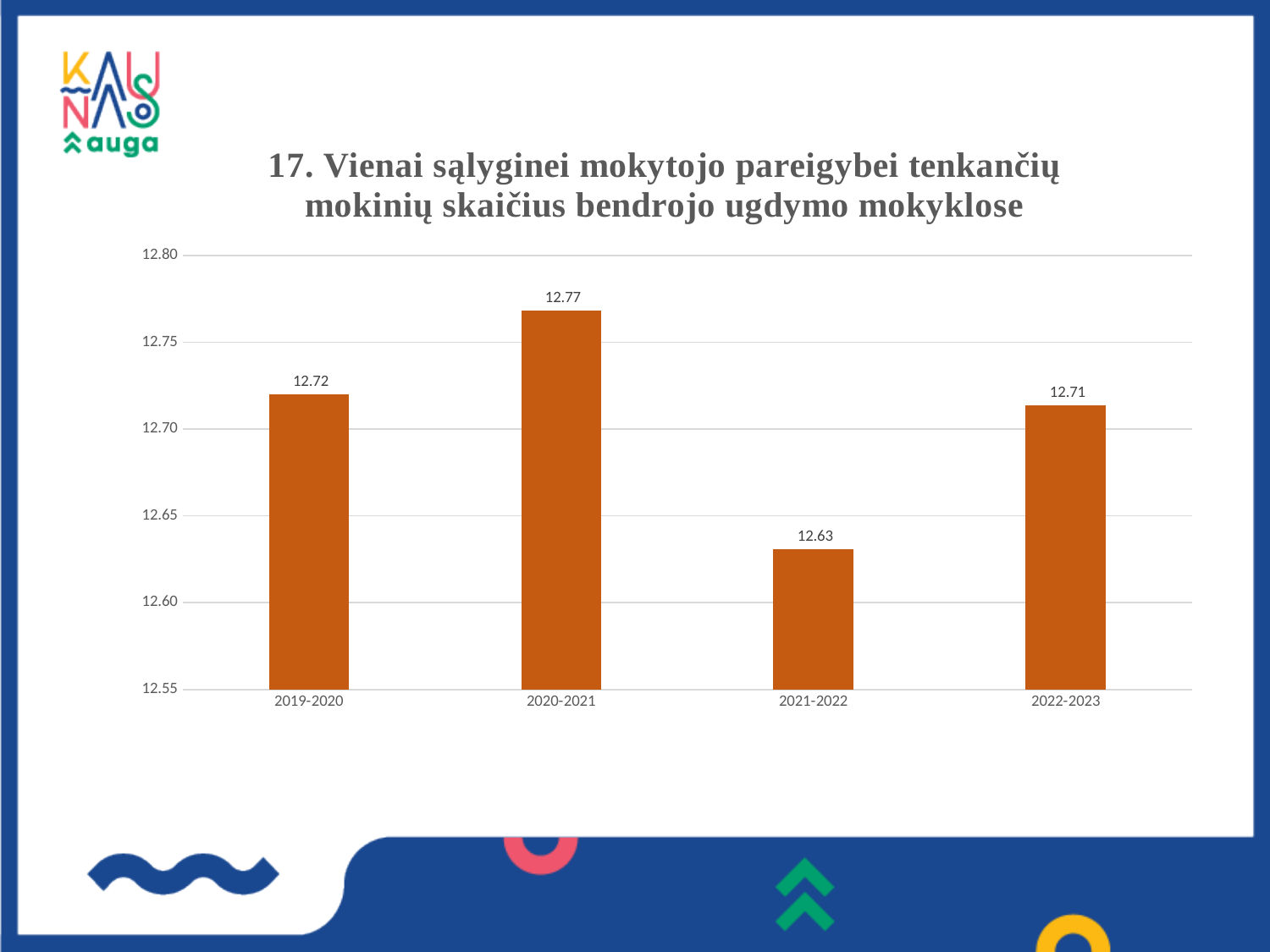
Which is larger, the value for 2019-2020 or the value for 2022-2023? 2019-2020 Is the value for 2021-2022 greater or less than 12.65? less What is the value for 2022-2023? 12.71 What is the value for 2021-2022? 12.63 What is the difference between the values for 2020-2021 and 2021-2022? 0.14 What is the value for 2020-2021? 12.77 What kind of chart is shown on the slide? bar chart Which school year has the highest value? 2020-2021 Does the value rise or fall from 2020-2021 to 2021-2022? fall Which school year has the lowest value? 2021-2022 What is the value for 2019-2020? 12.72 How many school years are shown on the chart? 4